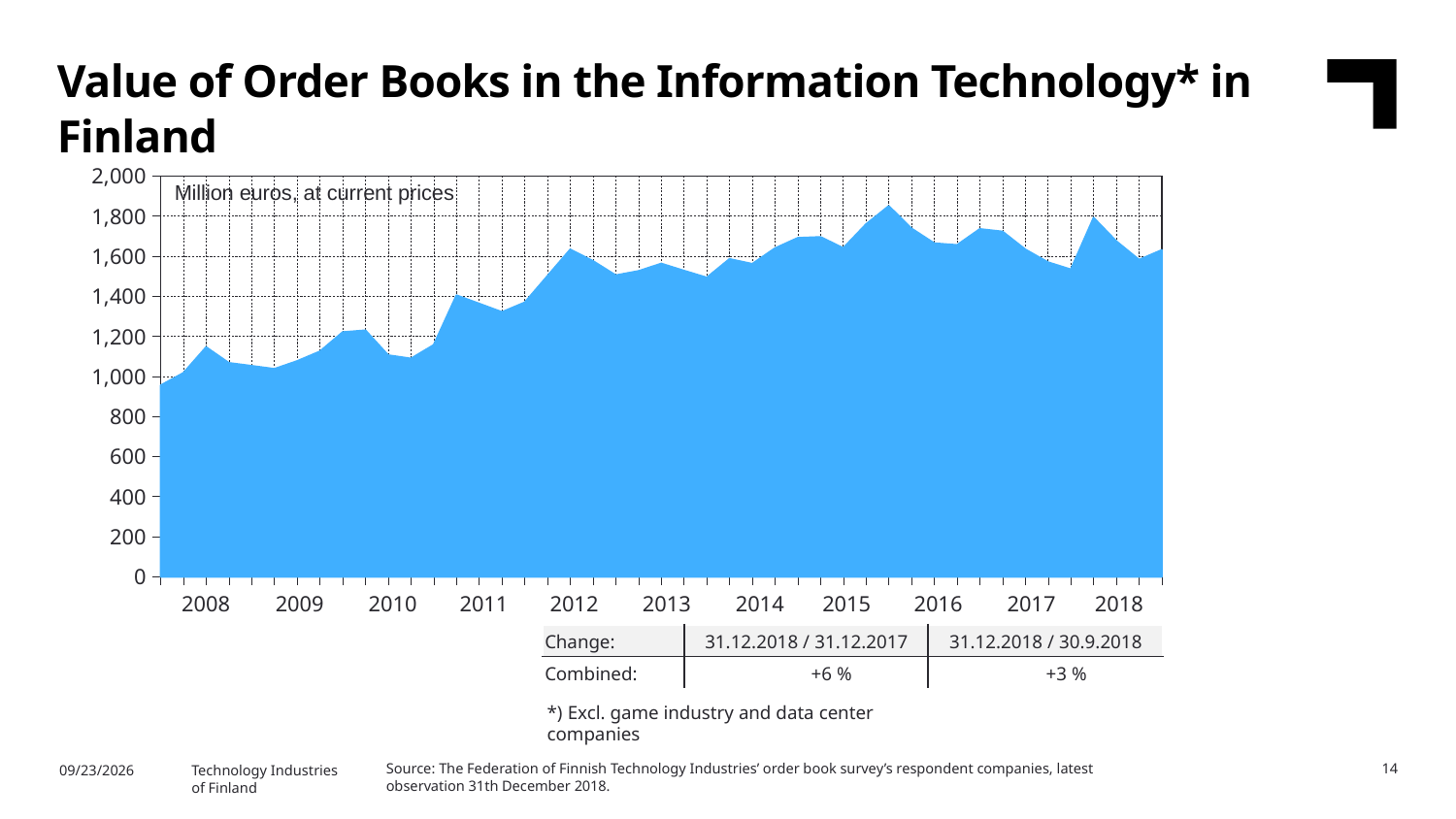
Is the value at the start of 2012 greater or less than 1,400? greater What is the title of the chart on the slide? Value of Order Books in the Information Technology* in Finland Is the value in 2015 larger than the value in 2010? Yes Is the value at the end of 2018 greater or less than 1,400? greater Is the value at the start of 2009 greater or less than 1,200? less In which year does the chart reach its highest peak? 2015 Overall, do the order book values rise or fall from 2008 to 2018? Rise In which year is the lowest value on the chart found? 2008 What kind of chart is shown on the slide? Area chart In what unit are the values on the chart expressed, according to the label inside the plot area? Million euros, at current prices How many years are labeled on the x axis of the chart? 11